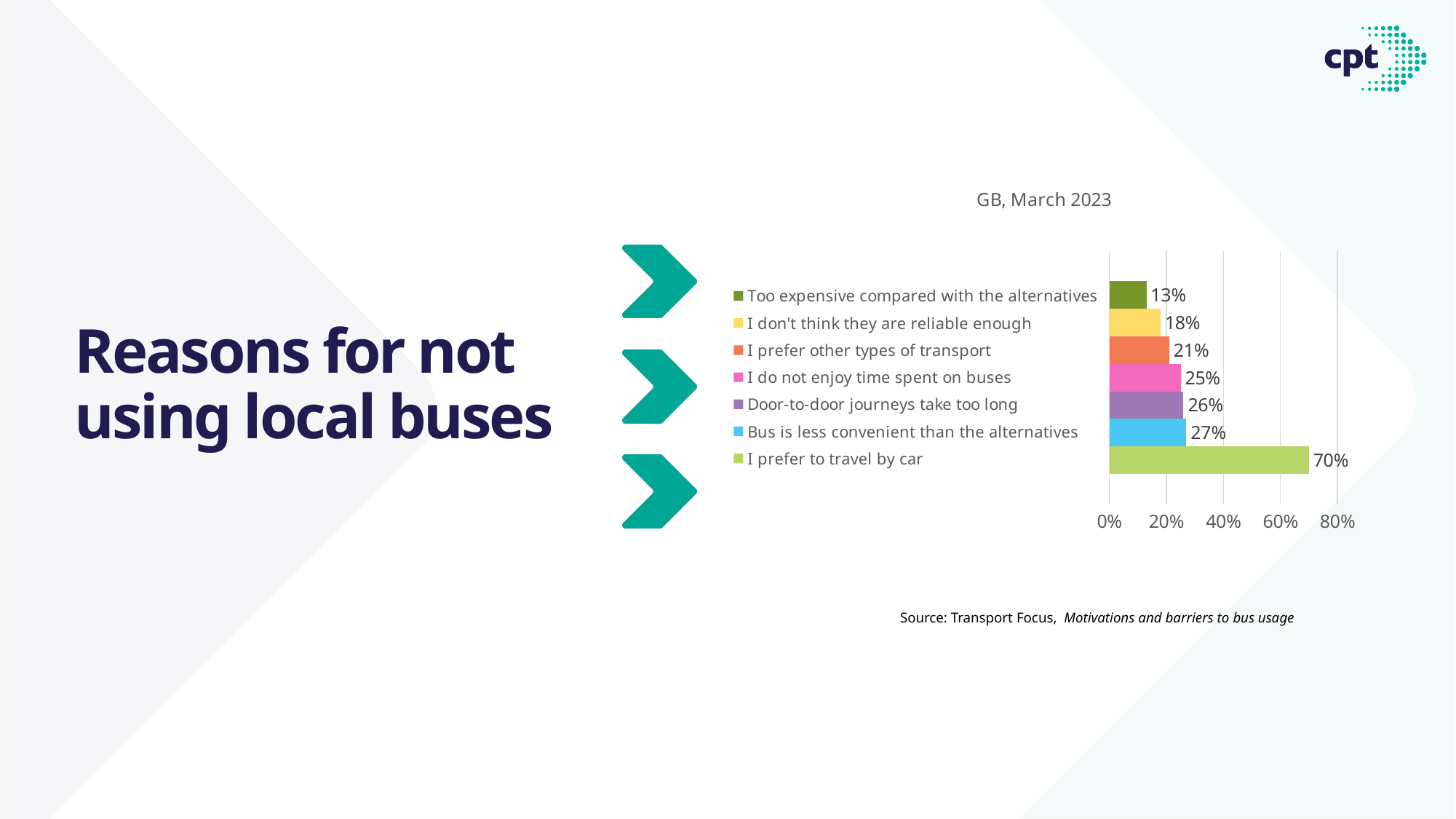
What is the difference between 'I prefer to travel by car' and 'Bus is less convenient than the alternatives'? 43% Which reason has the highest percentage? I prefer to travel by car Which is larger: 'I prefer other types of transport' or 'I do not enjoy time spent on buses'? I do not enjoy time spent on buses What type of chart is shown on the slide? Bar chart What percentage is shown for 'Door-to-door journeys take too long'? 26% What is the value for 'I don't think they are reliable enough'? 18% What percentage of respondents said 'I prefer to travel by car' as a reason for not using local buses? 70% What is the title shown above the chart? GB, March 2023 Which reason has the lowest percentage? Too expensive compared with the alternatives Is the value for 'I prefer to travel by car' greater or less than 60%? greater How many reasons are plotted in the chart? 7 What is the value for 'Too expensive compared with the alternatives'? 13%